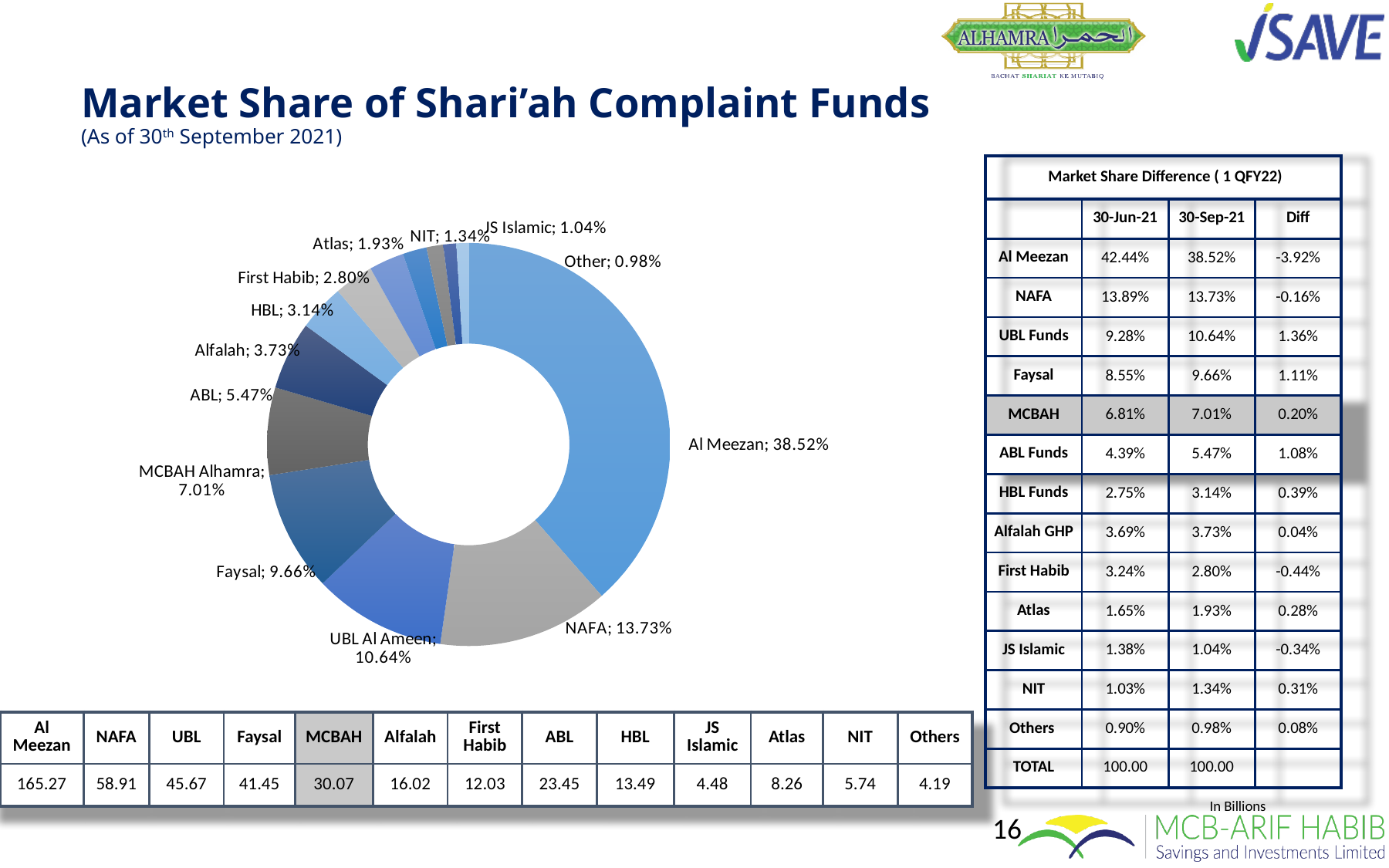
Which slice is the smallest in the chart? Other What is the difference between the market share of Faysal and MCBAH Alhamra in the chart? 2.65% What is the title of the slide containing the chart? Market Share of Shari'ah Complaint Funds What is the market share of NAFA in the chart? 13.73% What is the market share of UBL Al Ameen in the chart? 10.64% What kind of chart is shown on the slide? Doughnut (pie) chart What is the market share of MCBAH Alhamra in the chart? 7.01% How many slices does the chart have? 13 Which fund has the largest slice in the chart? Al Meezan What is the difference between the market share of Al Meezan and NAFA in the chart? 24.79% What is the market share of Al Meezan in the chart? 38.52% Which has a larger market share in the chart, Faysal or ABL? Faysal